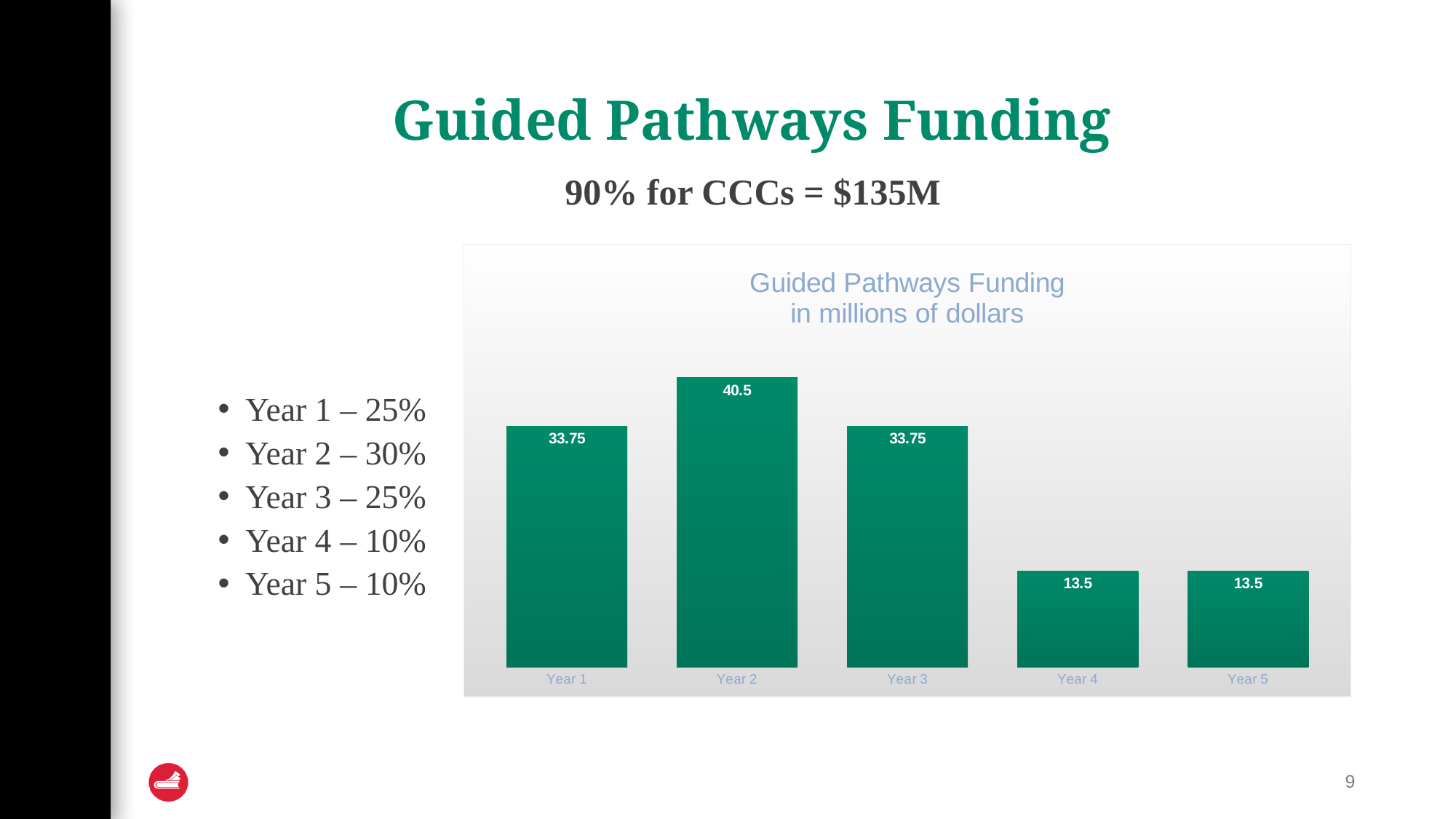
What is the difference between the values for Year 2 and Year 3? 6.75 What kind of chart is shown on the slide? Bar chart What colour are the bars in the chart? Green What is the title of the chart? Guided Pathways Funding in millions of dollars What is the value for Year 1 in the chart? 33.75 How many years are shown on the x axis of the chart? 5 What is the difference between the values for Year 1 and Year 5? 20.25 Which is larger, the value for Year 3 or the value for Year 4? Year 3 Which year has the highest funding in the chart? Year 2 What is the value for Year 4 in the chart? 13.5 Do the values rise or fall from Year 3 to Year 4? Fall What is the value for Year 2 in the chart? 40.5